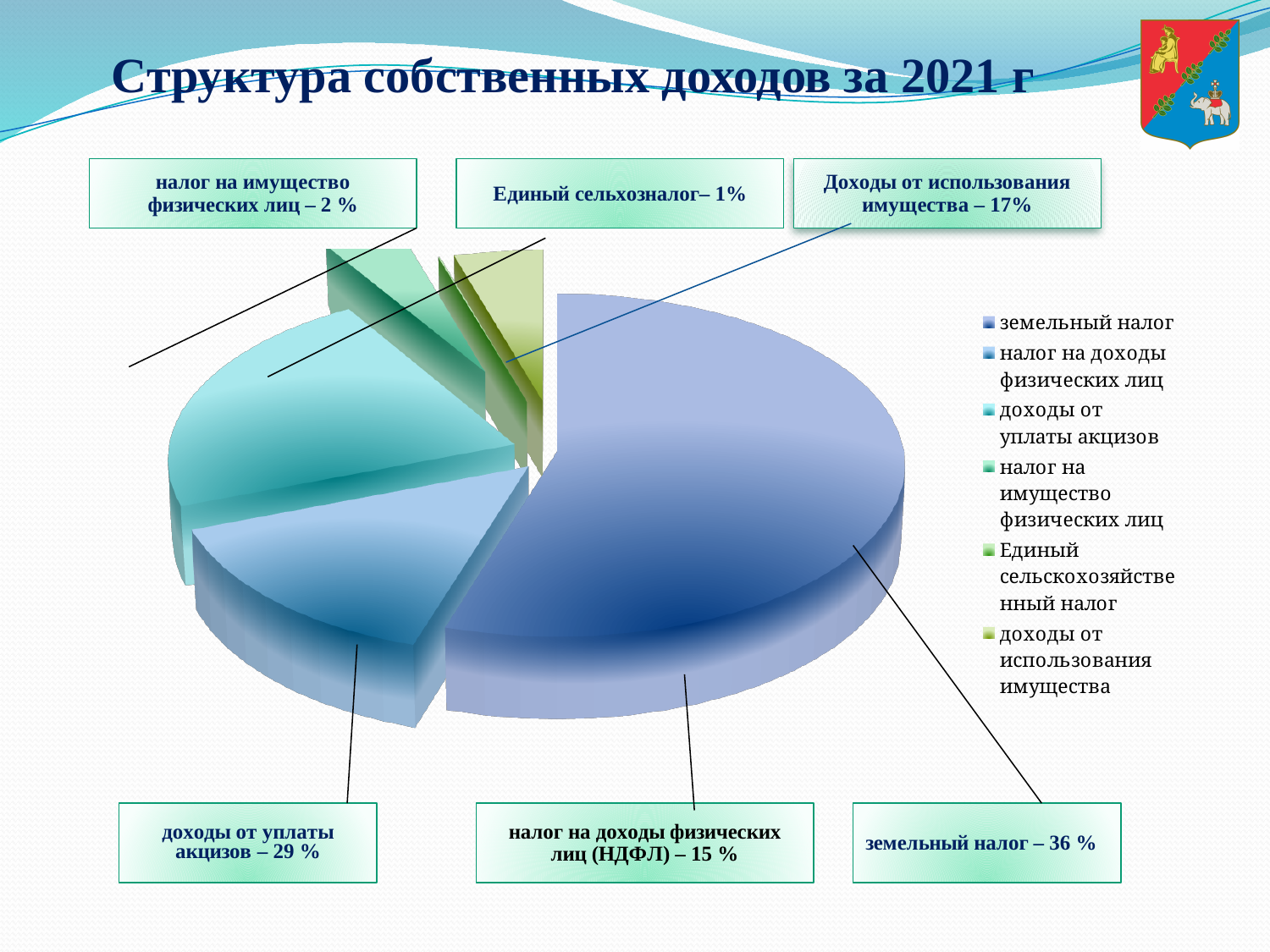
What is the title of the chart on the slide? Структура собственных доходов за 2021 г Which is larger: the share of Доходы от использования имущества or the share of налог на доходы физических лиц (НДФЛ)? Доходы от использования имущества Which category has the smallest share of the pie? Единый сельхозналог What is the value shown for доходы от уплаты акцизов? 29 % What share of the pie is земельный налог? 36 % What kind of chart is shown on the slide? pie chart What is the difference between the shares of земельный налог and доходы от уплаты акцизов? 7 % What is the value shown for Единый сельхозналог? 1% What is the value shown for налог на доходы физических лиц (НДФЛ)? 15 % What is the value shown for Доходы от использования имущества? 17% Which category has the largest share of the pie? земельный налог How many entries does the chart legend list? 6